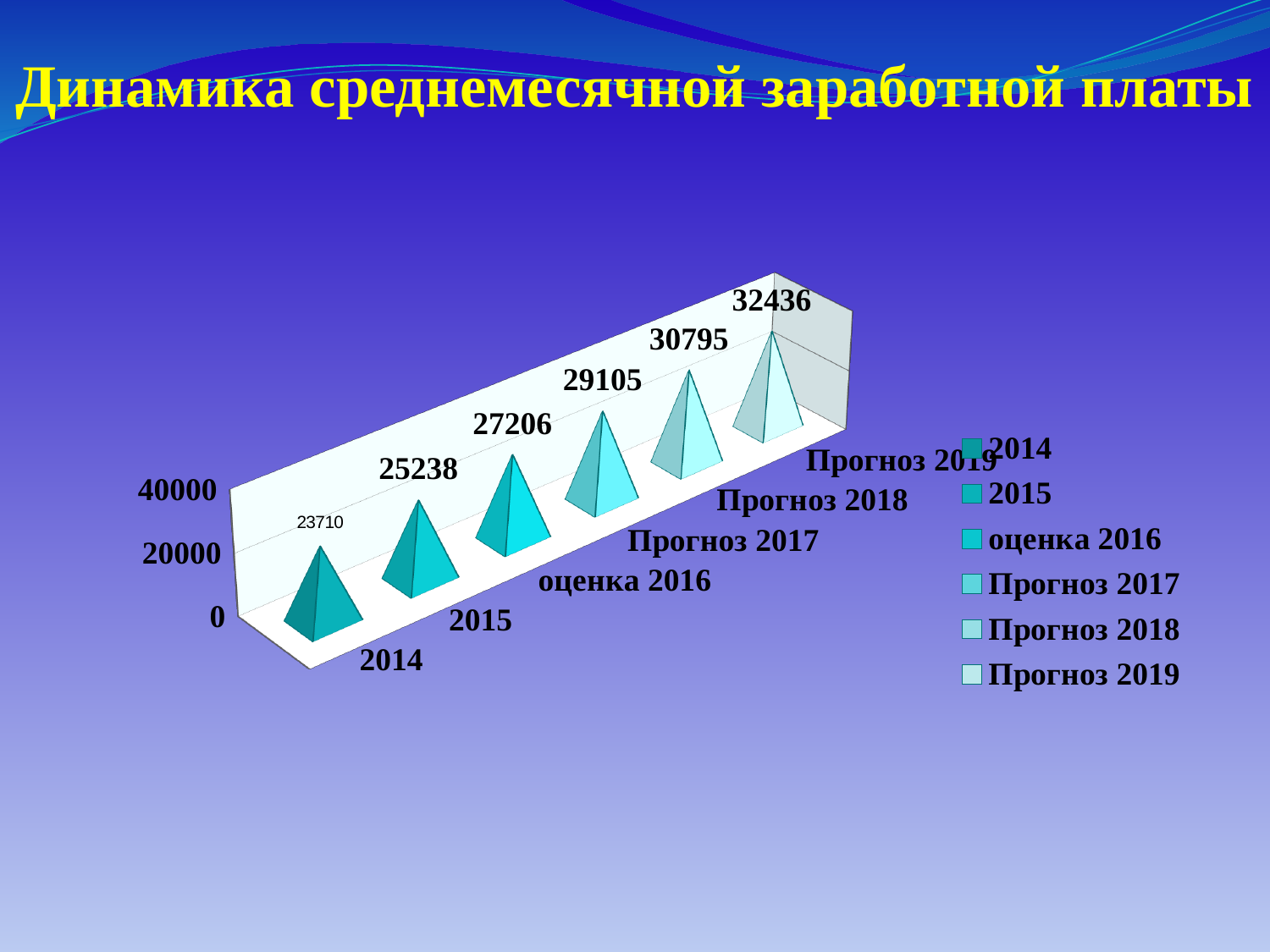
What is the difference between the values for Прогноз 2018 and Прогноз 2017? 1690 What is the value for 2014? 23710 What is the title of the chart? Динамика среднемесячной заработной платы How many categories are shown on the chart? 6 What is the value for оценка 2016? 27206 What is the value for Прогноз 2017? 29105 What is the value for 2015? 25238 Which is larger, the value for 2015 or the value for оценка 2016? оценка 2016 Which category has the lowest value? 2014 What is the value for Прогноз 2019? 32436 Do the values rise or fall from 2014 to Прогноз 2019? rise Which category has the highest value? Прогноз 2019